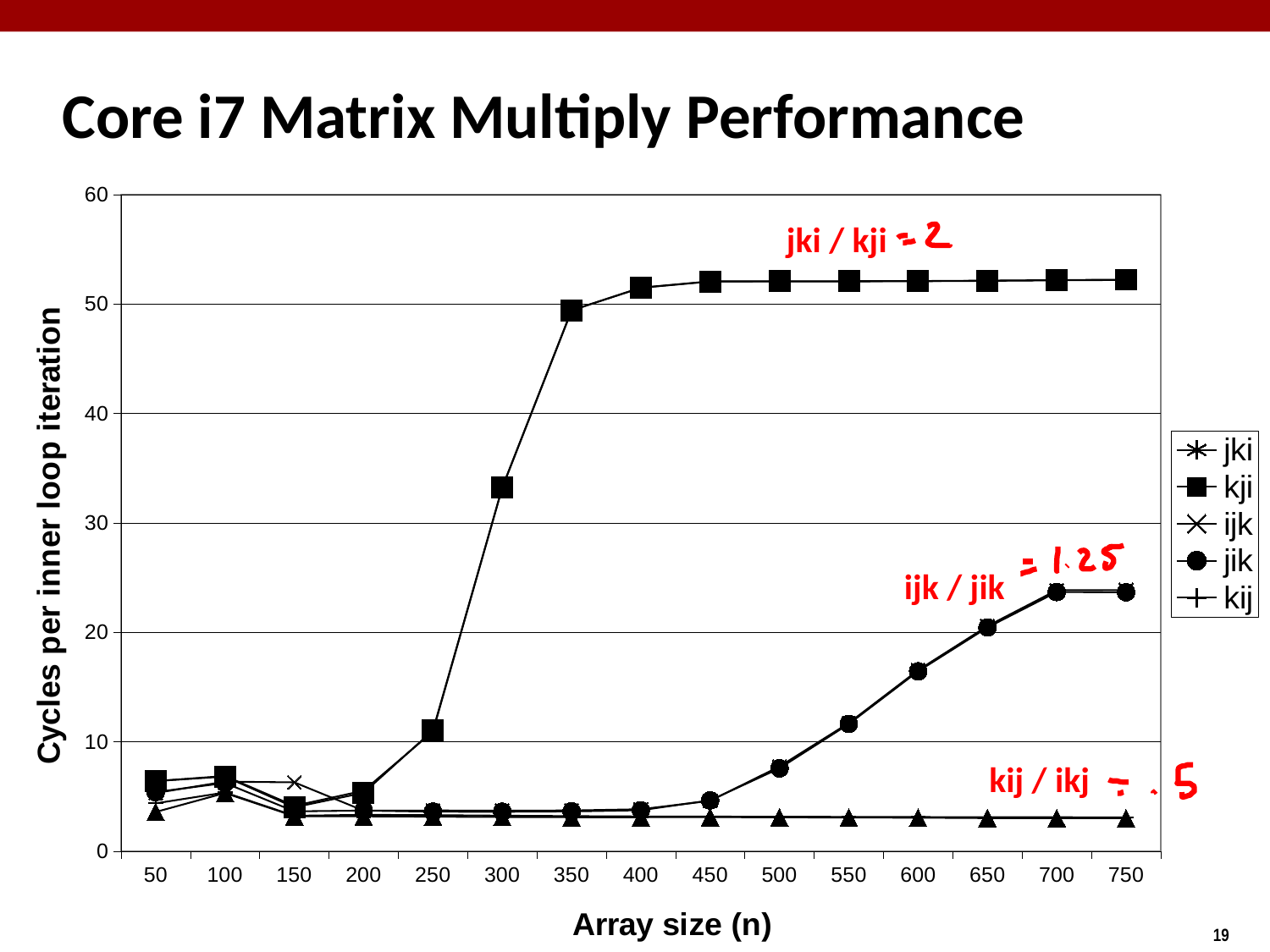
What is the title of the chart? Core i7 Matrix Multiply Performance At n = 750, which is larger, the value for kji or the value for jik? kji What kind of chart is shown on the slide? line chart What is the label of the y axis? Cycles per inner loop iteration Does the kji series rise or fall as the array size increases from 200 to 400? rise Is the value for jik at n = 500 greater or less than 10? less Is the value for kji at n = 300 greater or less than 30? greater Is the value for jik at n = 750 greater or less than 20? greater How many array sizes are marked along the x axis? 15 How many series does the legend list? 5